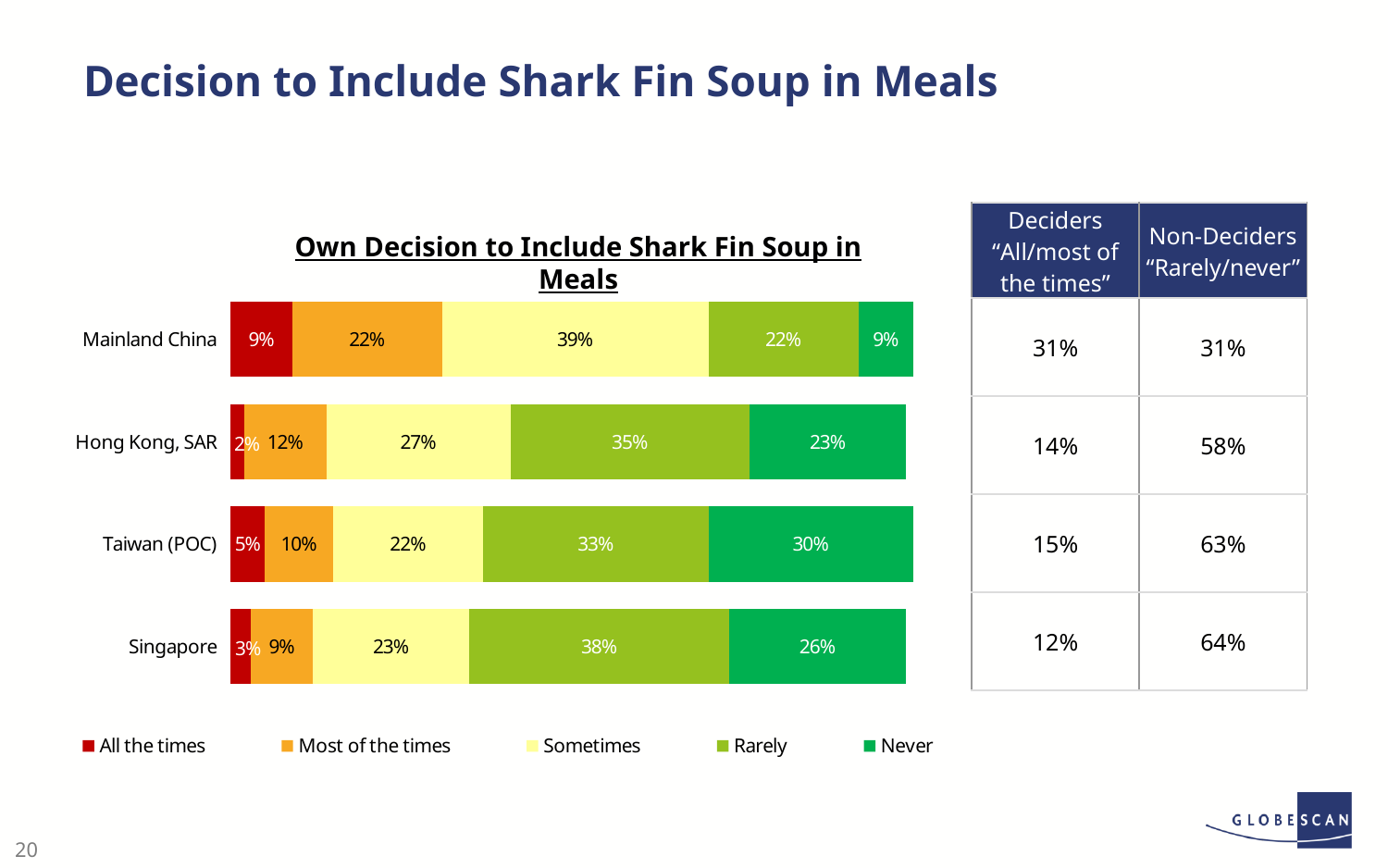
How many series does the legend list? 5 What is the 'Never' value for Taiwan (POC)? 30% How many categories (regions) are shown in the chart? 4 What is the title of the chart? Own Decision to Include Shark Fin Soup in Meals Which category has the lowest 'Never' value? Mainland China Which has a larger 'Sometimes' value, Hong Kong, SAR or Singapore? Hong Kong, SAR What kind of chart is shown on the slide? Stacked bar chart Which category has the highest 'Never' value? Taiwan (POC) Which category has the highest 'Most of the times' value? Mainland China What is the 'All the times' value for Hong Kong, SAR? 2% What percentage of respondents in Mainland China say they 'Sometimes' decide to include shark fin soup in meals? 39% How much larger is the 'Rarely' value for Singapore than for Mainland China? 16 percentage points